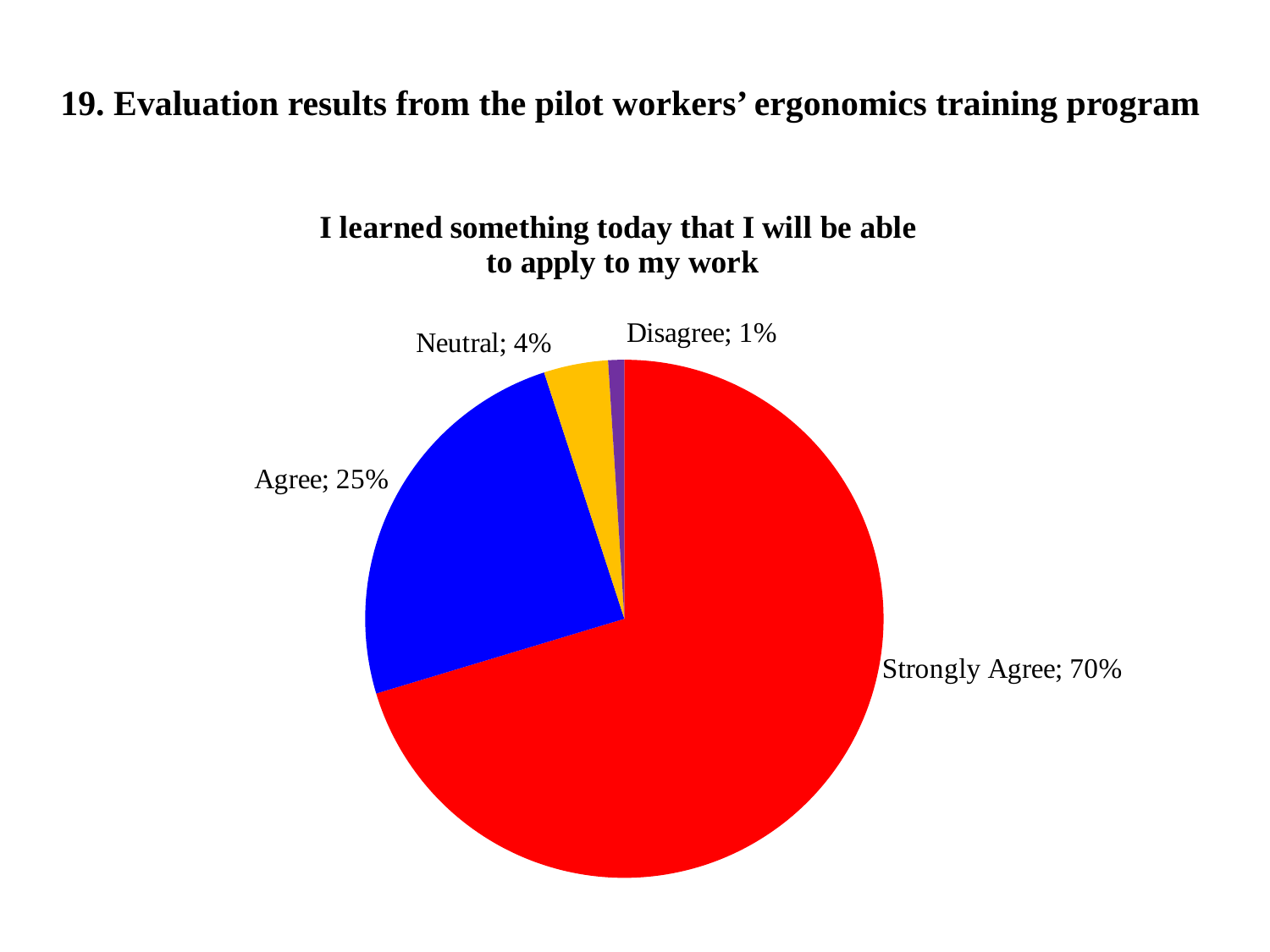
Which response category has the smallest share of the pie? Disagree What percentage of respondents answered Disagree? 1% What percentage of respondents answered Strongly Agree? 70% What is the difference in percentage points between Strongly Agree and Agree? 45 Which is larger, the share for Agree or the share for Neutral? Agree What is the title of the pie chart? I learned something today that I will be able to apply to my work What percentage of respondents answered Neutral? 4% What colour is the Agree slice of the pie? blue How many response categories are shown in the pie chart? 4 What kind of chart is shown on the slide? pie chart What percentage of respondents answered Agree? 25% Which response category has the largest share of the pie? Strongly Agree